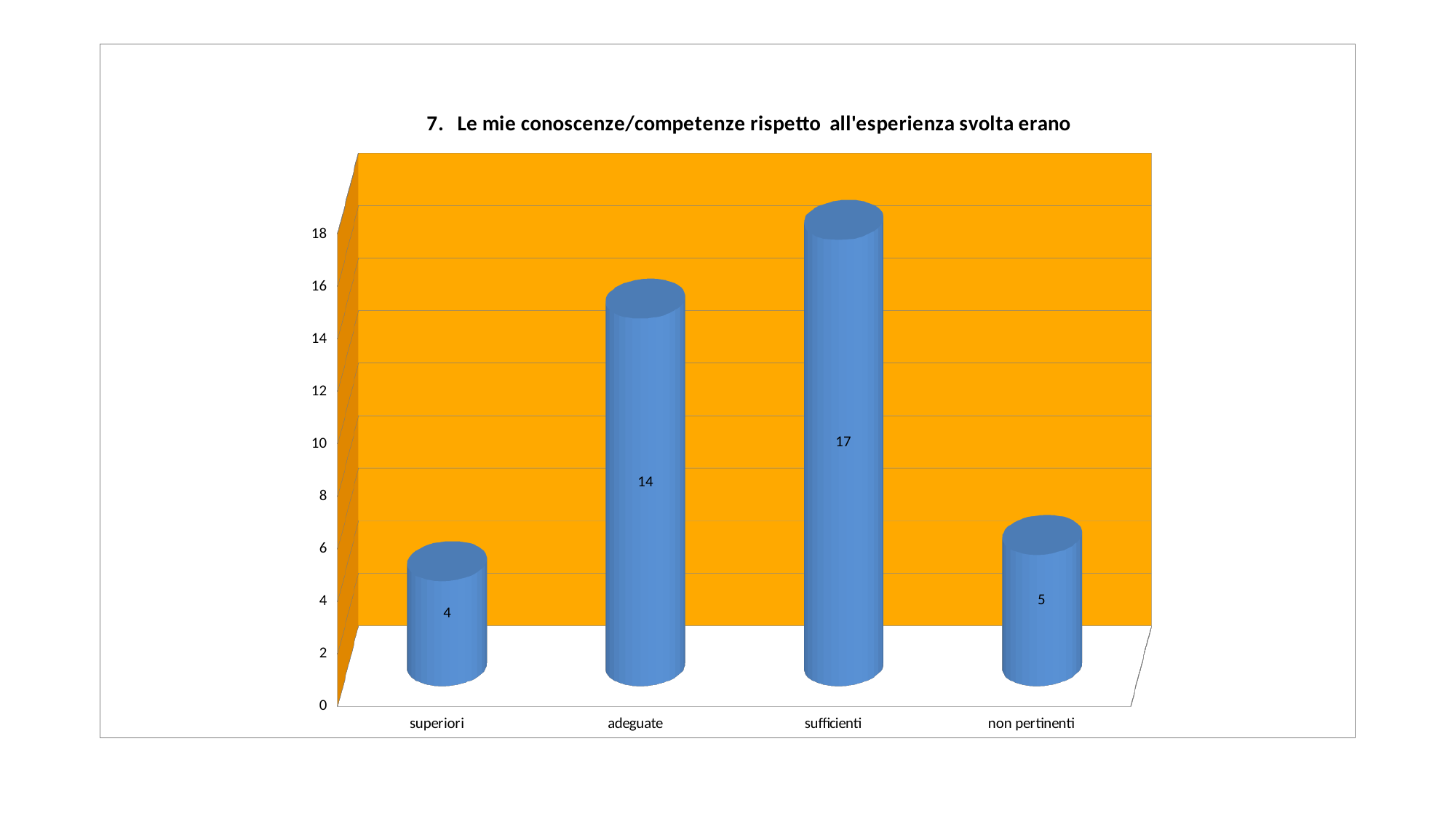
What is the value for "adeguate"? 14 What is the value for "sufficienti"? 17 Which category has the lowest value? superiori What kind of chart is shown on the slide? bar chart What is the value for "superiori"? 4 How many categories are shown on the x axis? 4 What is the value for "non pertinenti"? 5 What is the title of the chart? 7. Le mie conoscenze/competenze rispetto all'esperienza svolta erano Which is larger, the value for "non pertinenti" or the value for "superiori"? non pertinenti Is the value for "adeguate" greater or less than 10? greater What is the difference between the values for "sufficienti" and "adeguate"? 3 Which category has the highest value? sufficienti